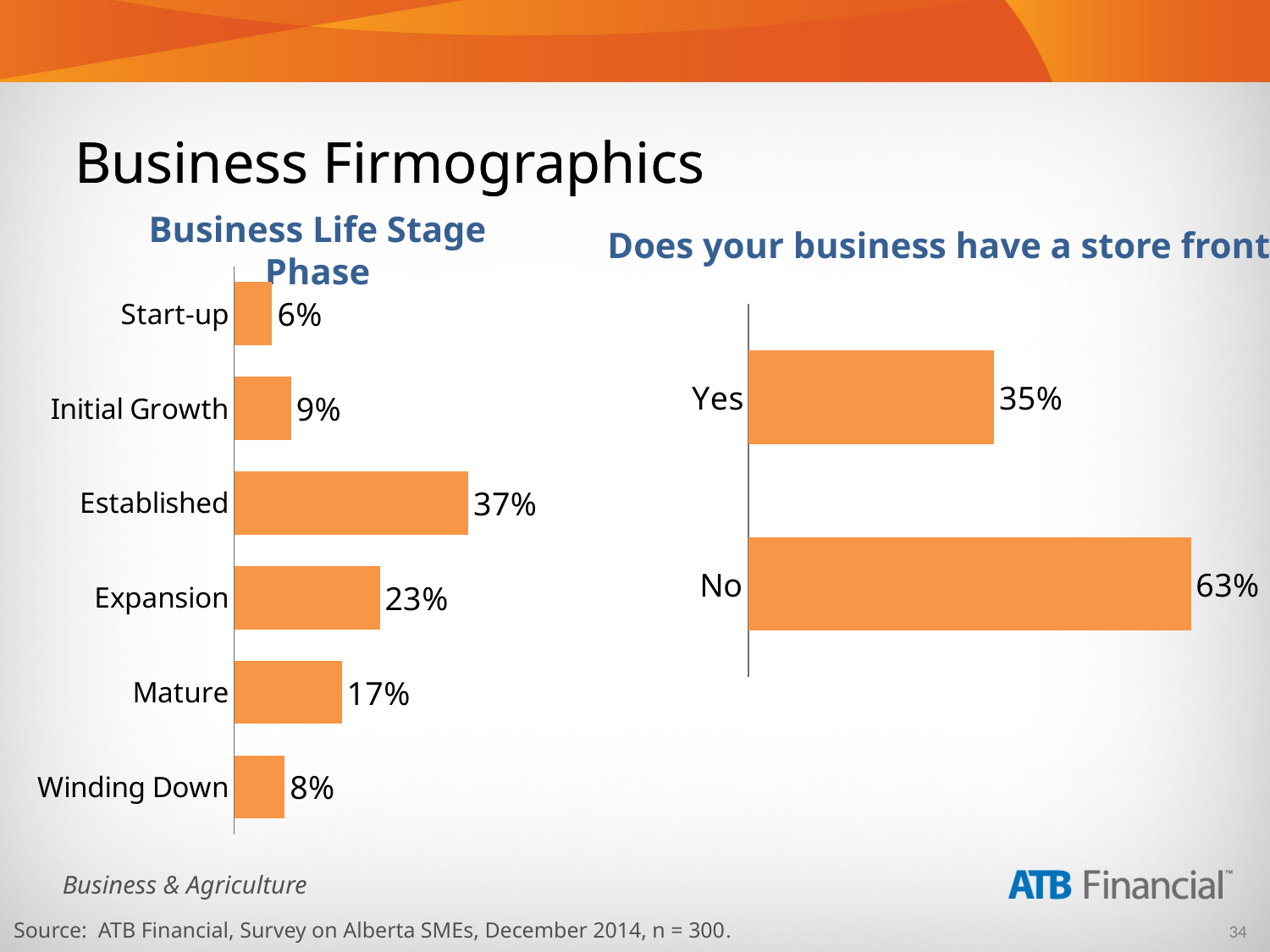
In the Business Life Stage Phase chart, what is the value for Mature? 17% In the 'Does your business have a store front' chart, what percentage answered Yes? 35% In the 'Does your business have a store front' chart, what percentage answered No? 63% In the Business Life Stage Phase chart, which life stage has the highest percentage? Established In the Business Life Stage Phase chart, which is larger, Initial Growth or Winding Down? Initial Growth How many life stage categories are shown in the Business Life Stage Phase chart? 6 In the Business Life Stage Phase chart, what percentage of businesses are in the Established phase? 37% What is the title of the chart on the left side of the slide? Business Life Stage Phase What type of chart is the 'Does your business have a store front' chart? Bar chart In the Business Life Stage Phase chart, which life stage has the lowest percentage? Start-up In the 'Does your business have a store front' chart, what is the difference between the No and Yes percentages? 28% In the Business Life Stage Phase chart, what is the difference between the Established and Expansion percentages? 14%